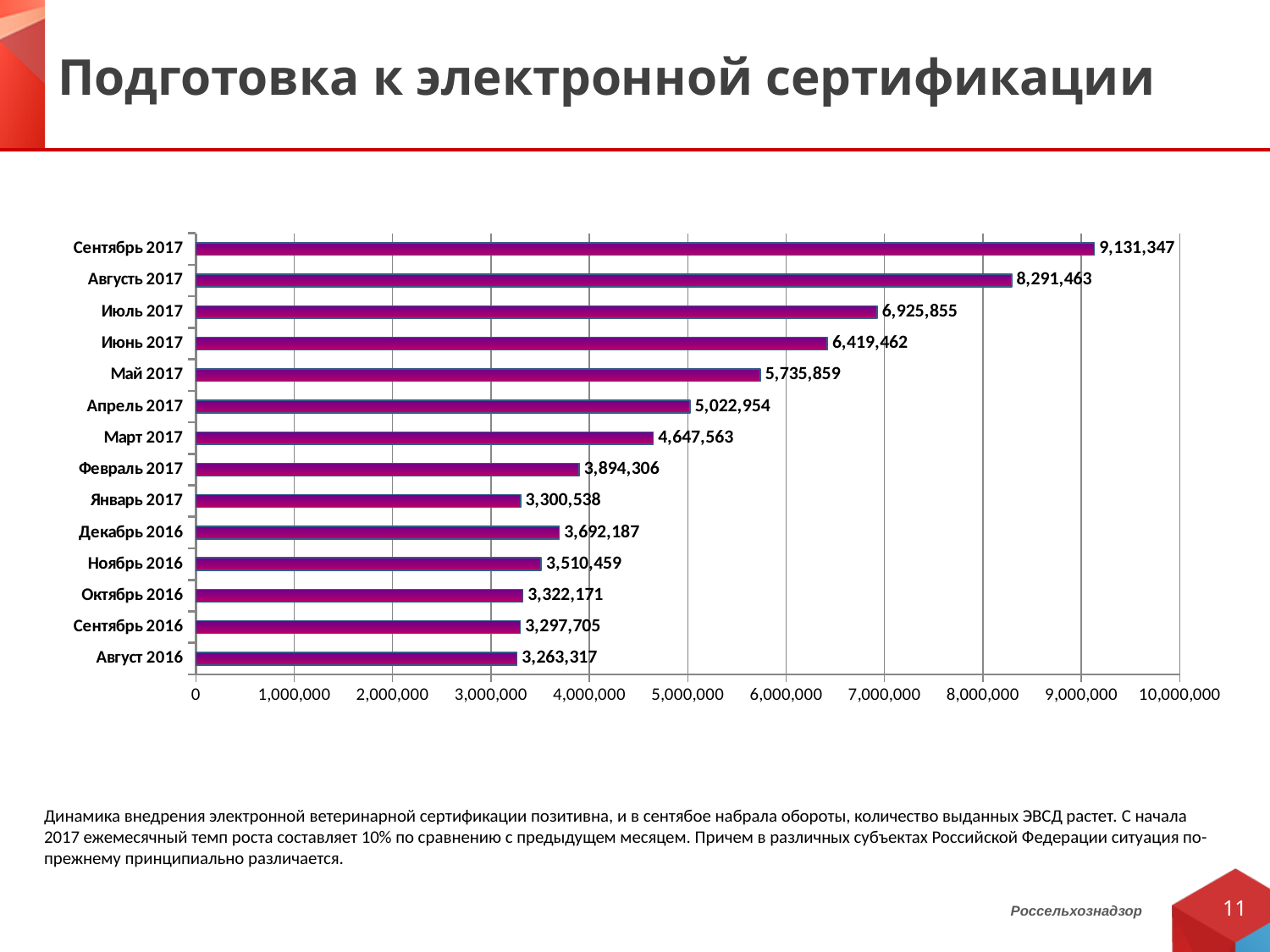
What kind of chart is shown on the slide? bar chart How many months are shown in the chart? 14 Which month has the lowest value? Август 2016 What is the value for Апрель 2017? 5,022,954 Which is larger, the value for Декабрь 2016 or the value for Январь 2017? Декабрь 2016 What is the value for Август 2016? 3,263,317 Do the values generally rise or fall from Август 2016 to Сентябрь 2017? rise Which month has the highest value? Сентябрь 2017 What is the difference between the values for Сентябрь 2017 and Август 2017? 839,884 What is the value for Сентябрь 2017? 9,131,347 What is the value for Январь 2017? 3,300,538 Is the value for Май 2017 greater or less than 5,000,000? greater